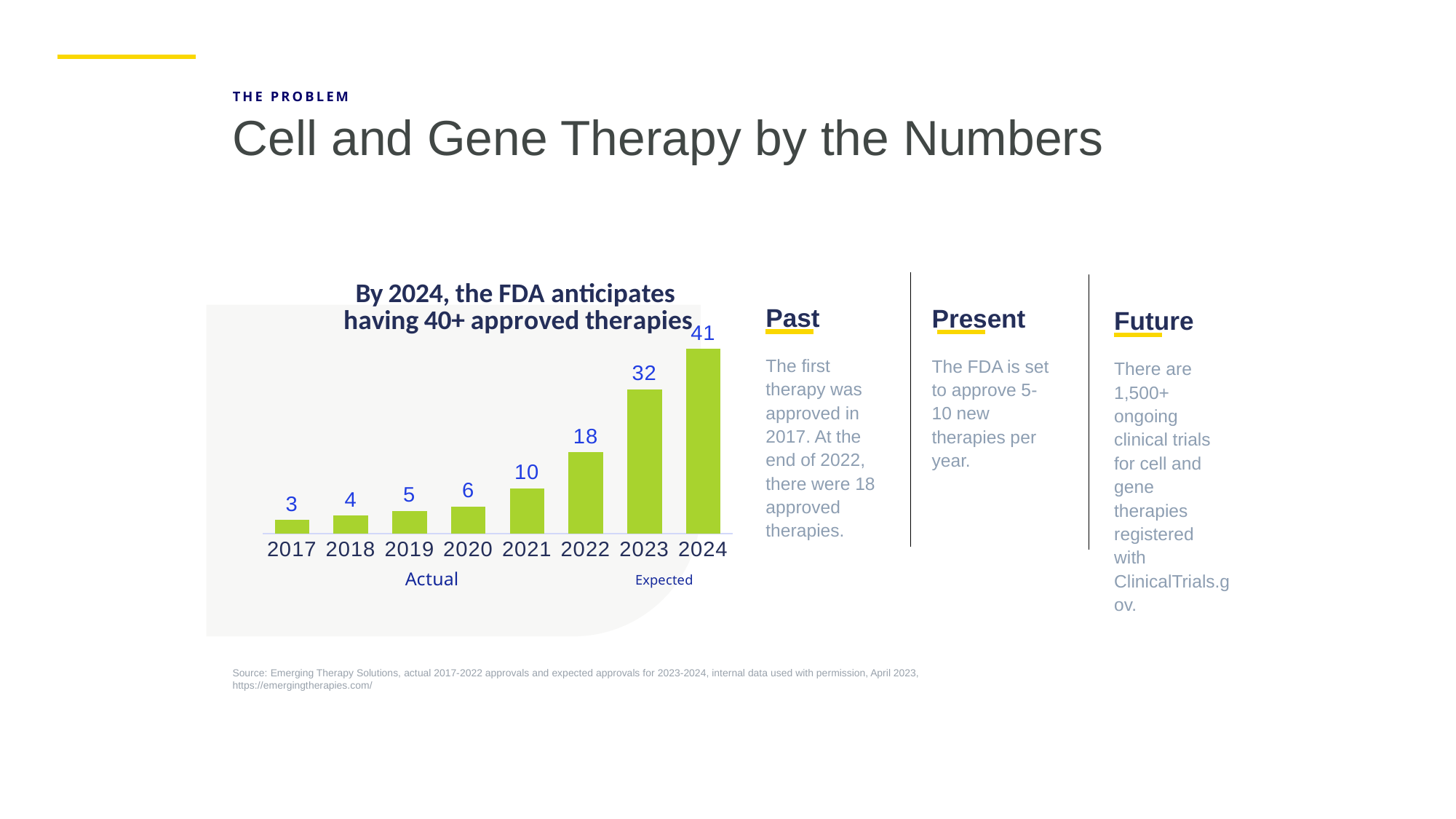
Which is larger, the value for 2021 or the value for 2019? 2021 What is the difference between the values for 2024 and 2017? 38 What is the expected value for 2024? 41 How many years are shown on the x axis? 8 Which year has the highest value? 2024 What is the difference between the values for 2023 and 2022? 14 What is the value for 2020? 6 What kind of chart is shown? Bar chart What is the value for 2017? 3 What is the value for 2022? 18 Which year has the lowest value? 2017 Do the values rise or fall from 2017 to 2024? Rise